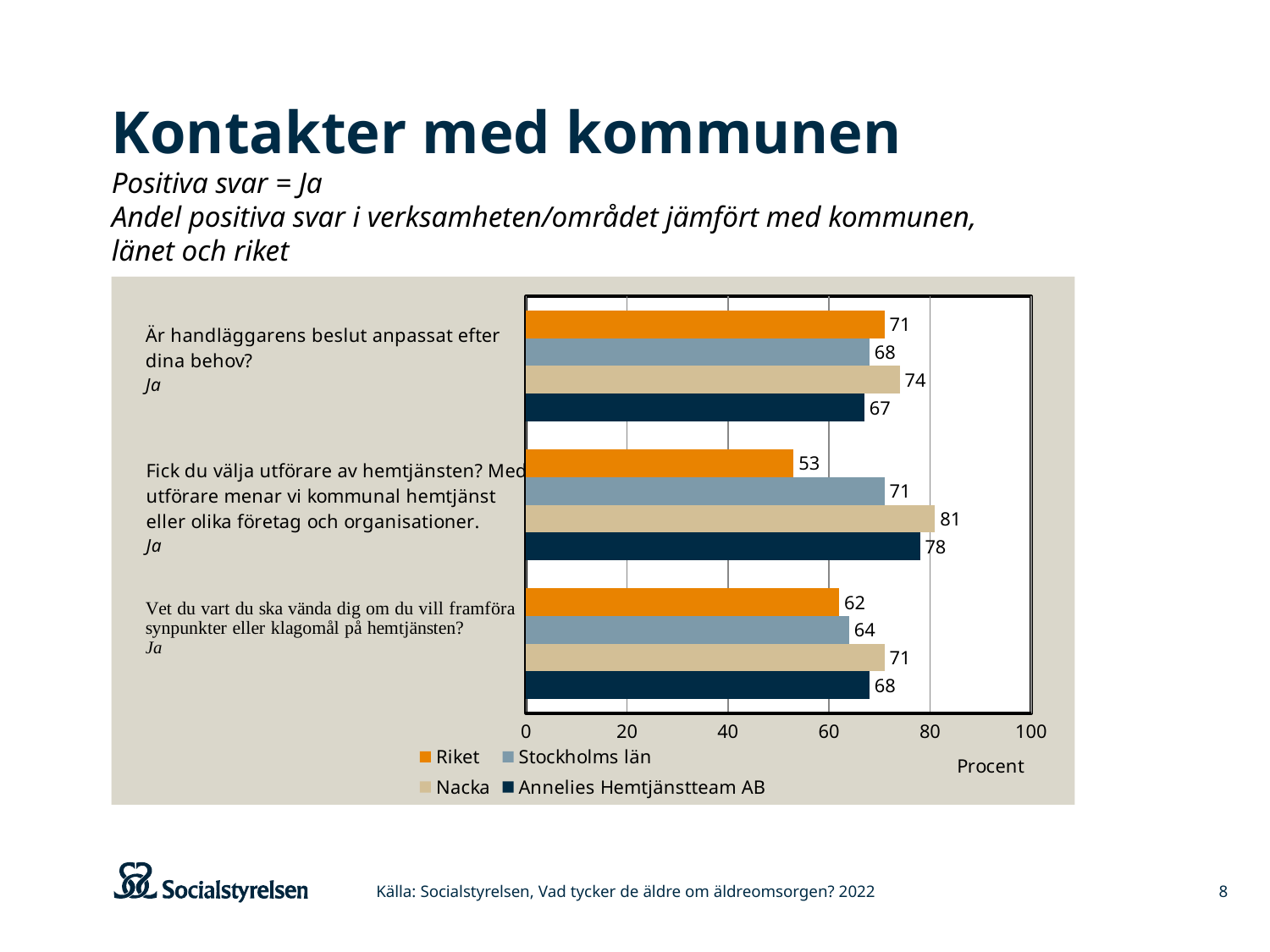
What kind of chart is shown on the slide? bar chart How many question categories are plotted on the chart? 3 What is the value for Riket on the question "Är handläggarens beslut anpassat efter dina behov?"? 71 How many series does the legend list? 4 Which series has the lowest value on the question "Fick du välja utförare av hemtjänsten?"? Riket What unit is shown on the x axis of the chart? Procent What is the difference between Nacka and Riket on the question "Fick du välja utförare av hemtjänsten?"? 28 What is the value for Annelies Hemtjänstteam AB on the question "Vet du vart du ska vända dig om du vill framföra synpunkter eller klagomål på hemtjänsten?"? 68 What is the value for Nacka on the question "Fick du välja utförare av hemtjänsten?"? 81 Which is larger on the question "Vet du vart du ska vända dig om du vill framföra synpunkter eller klagomål på hemtjänsten?": Nacka or Stockholms län? Nacka Which series has the highest value on the question "Är handläggarens beslut anpassat efter dina behov?"? Nacka Is the value for Riket on the question "Fick du välja utförare av hemtjänsten?" greater or less than 60? less